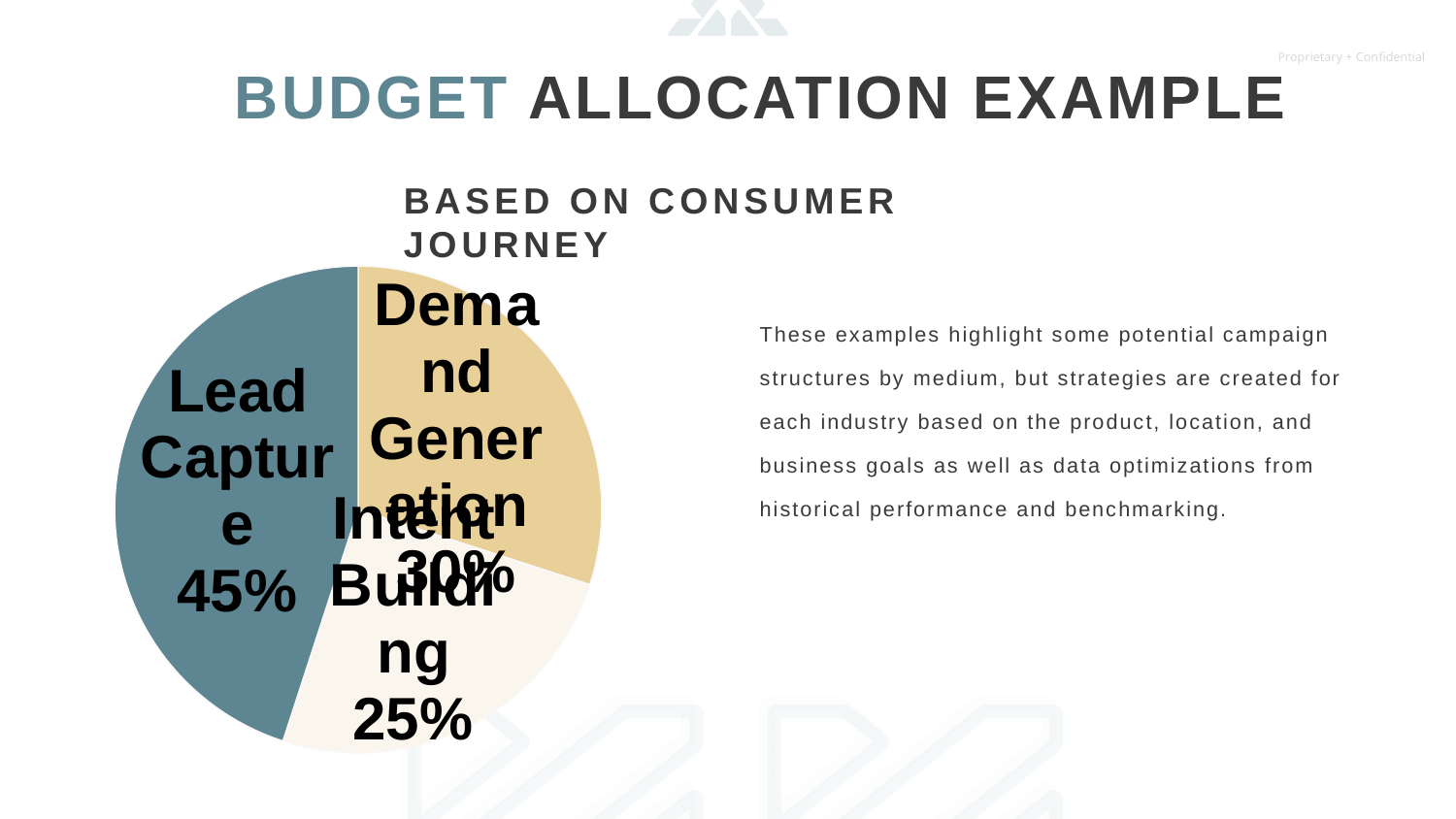
What kind of chart is shown on the slide? Pie chart What is the difference in percentage points between Lead Capture and Intent Building? 20 Which slice of the pie chart is the smallest? Intent Building What share of the budget is allocated to Intent Building? 25% What share of the budget is allocated to Lead Capture? 45% What is the difference in percentage points between Demand Generation and Intent Building? 5 What share of the budget is allocated to Demand Generation? 30% What colour is the Lead Capture slice of the pie chart? Teal (blue-grey) How many slices does the pie chart have? 3 Which is larger, the share for Demand Generation or the share for Intent Building? Demand Generation Which slice of the pie chart is the largest? Lead Capture What is the title shown above the pie chart? BASED ON CONSUMER JOURNEY